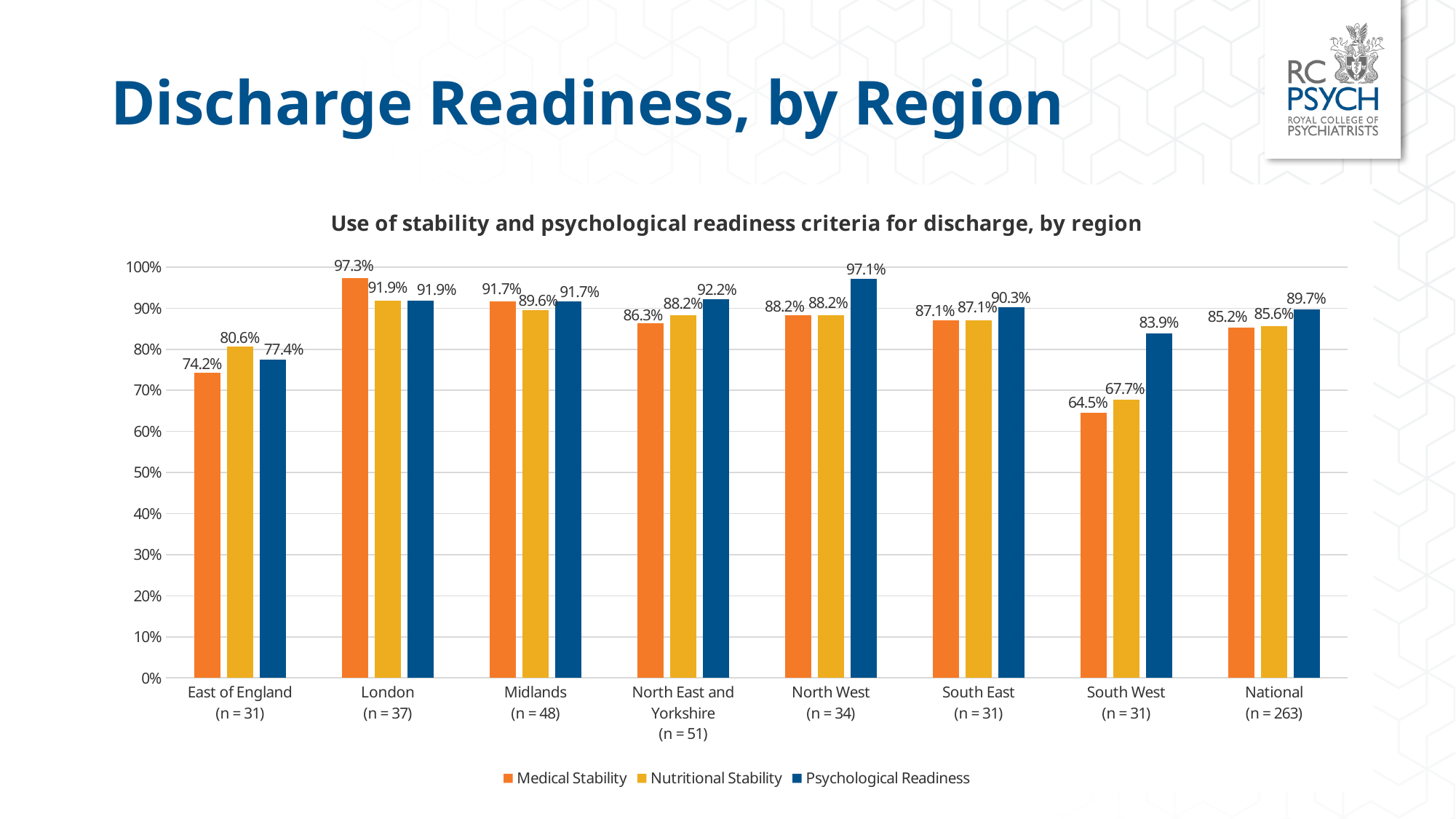
What kind of chart is shown on the slide? Bar chart How many series does the legend list? 3 Which region has the lowest Medical Stability value? South West What is the Medical Stability value for London? 97.3% Is the Medical Stability value for East of England greater or less than 80%? less Which region has the highest Psychological Readiness value? North West What is the sample size (n) shown for the Midlands? 48 What is the difference between the Psychological Readiness and Medical Stability values for South West? 19.4% What is the Psychological Readiness value for South West? 83.9% What is the Nutritional Stability value for National? 85.6% Which is larger for East of England: Nutritional Stability or Psychological Readiness? Nutritional Stability How many regions (categories) are shown on the x axis? 8